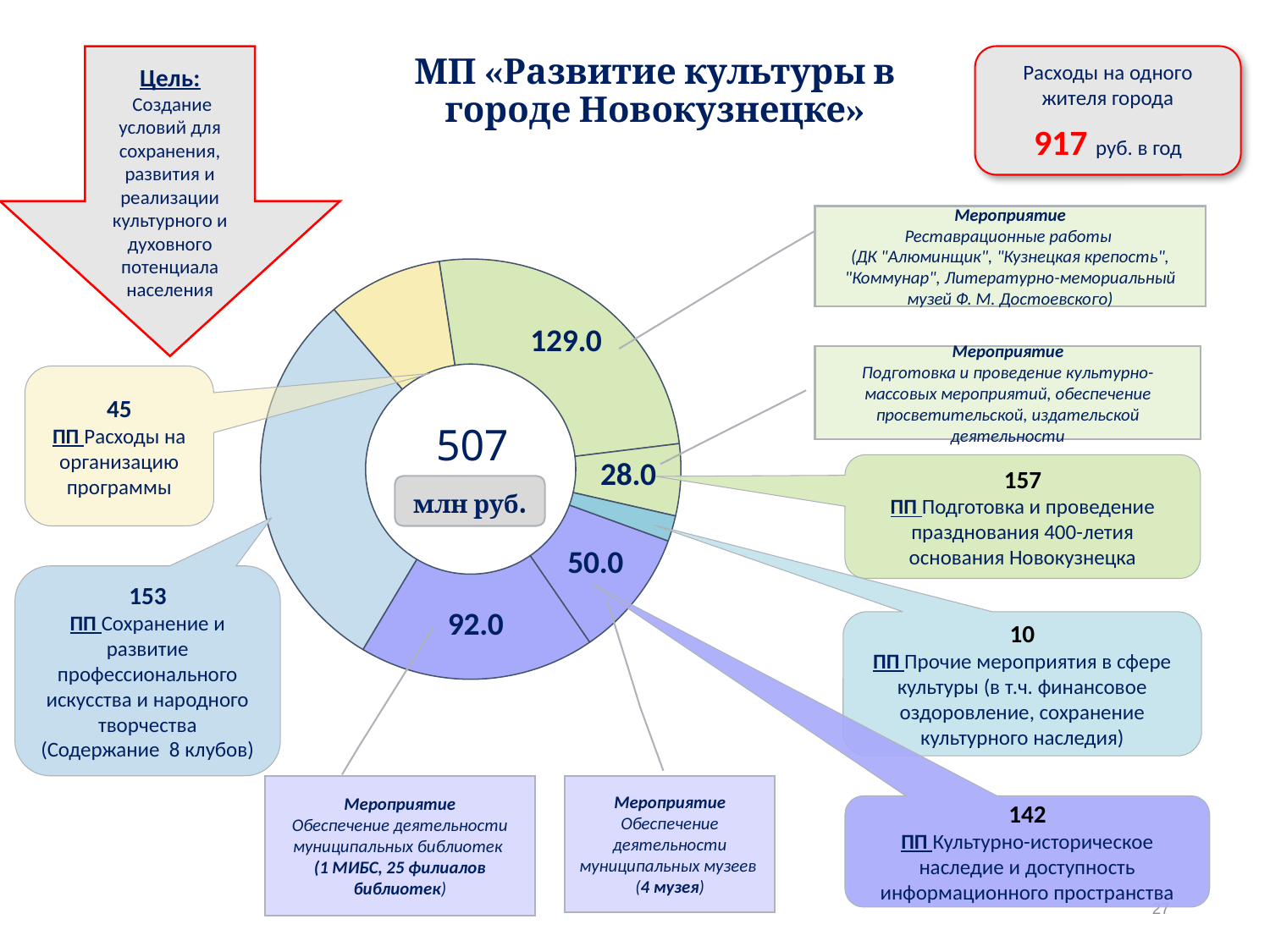
What value is printed on the smaller purple-blue slice of the chart? 50.0 What value is printed on the large green slice of the chart? 129.0 What value is printed on the small green slice of the chart? 28.0 What value is given in the callout for 'ПП Расходы на организацию программы'? 45 Which slice of the chart is the smallest? ПП Прочие мероприятия в сфере культуры (10) What value is printed on the large purple-blue slice of the chart? 92.0 What is the title of the programme shown above the chart? МП «Развитие культуры в городе Новокузнецке» What kind of chart is shown on the slide? Doughnut (pie) chart What total value is shown in the centre of the doughnut chart? 507 млн руб. What value is given in the callout for 'ПП Сохранение и развитие профессионального искусства и народного творчества'? 153 Which is larger: the slice labelled 129.0 or the slice labelled 92.0? 129.0 What is the difference between the slice labelled 129.0 and the slice labelled 92.0? 37.0